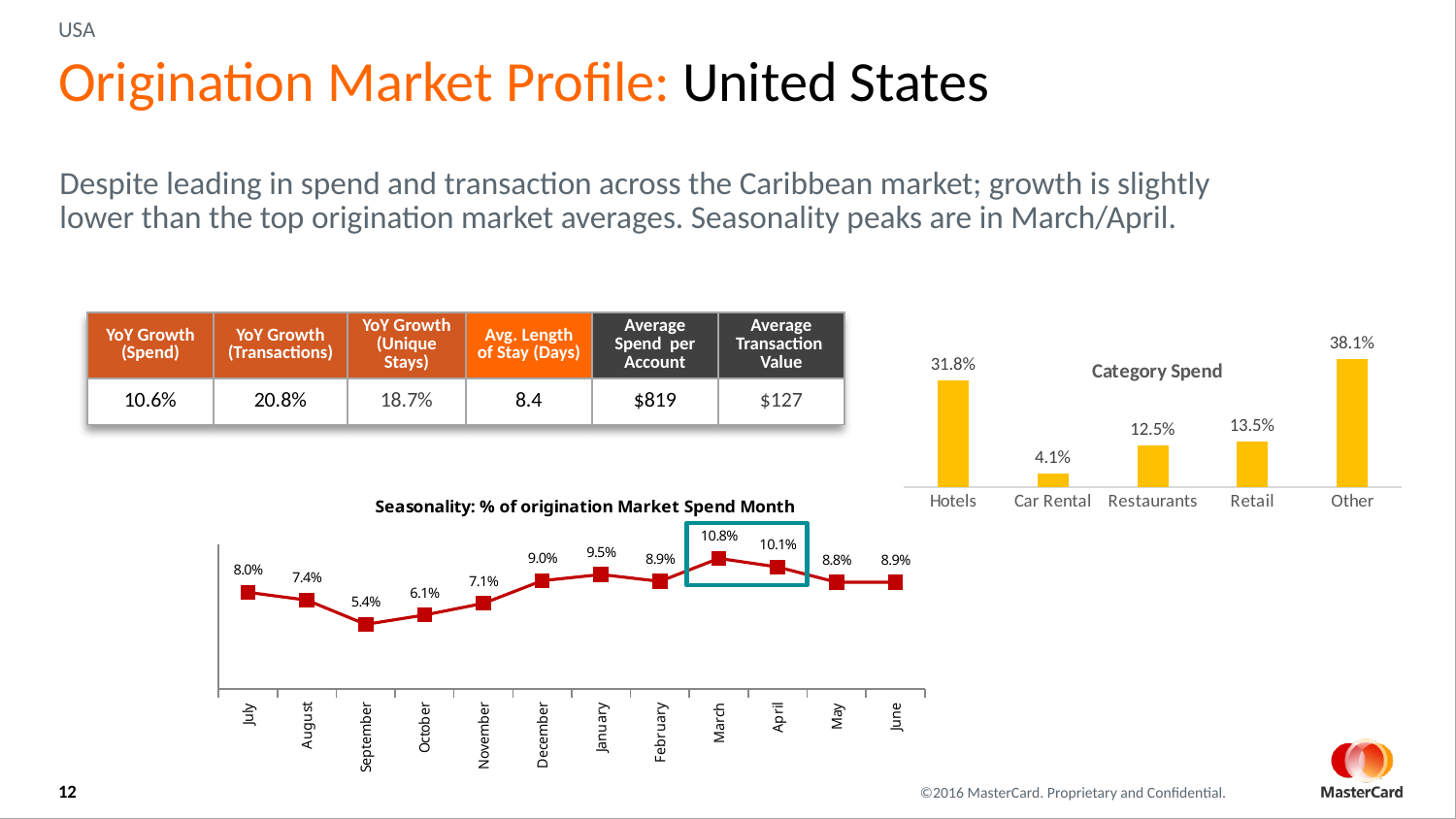
In the Seasonality chart, which month has the highest value? March In the Category Spend chart, what is the value for Hotels? 31.8% In the Category Spend chart, how many categories are shown? 5 In the Category Spend chart, which category has the lowest value? Car Rental In the Category Spend chart, what is the difference between Retail and Restaurants? 1.0% In the Seasonality chart, which month has the lowest value? September In the Category Spend chart, which category has the highest value? Other In the Seasonality chart, what is the difference between March and April? 0.7% What kind of chart is the Category Spend chart? bar chart In the Seasonality chart, what is the value for March? 10.8% In the Seasonality chart, which is larger, the value for January or the value for December? January What kind of chart is the Seasonality chart? line chart